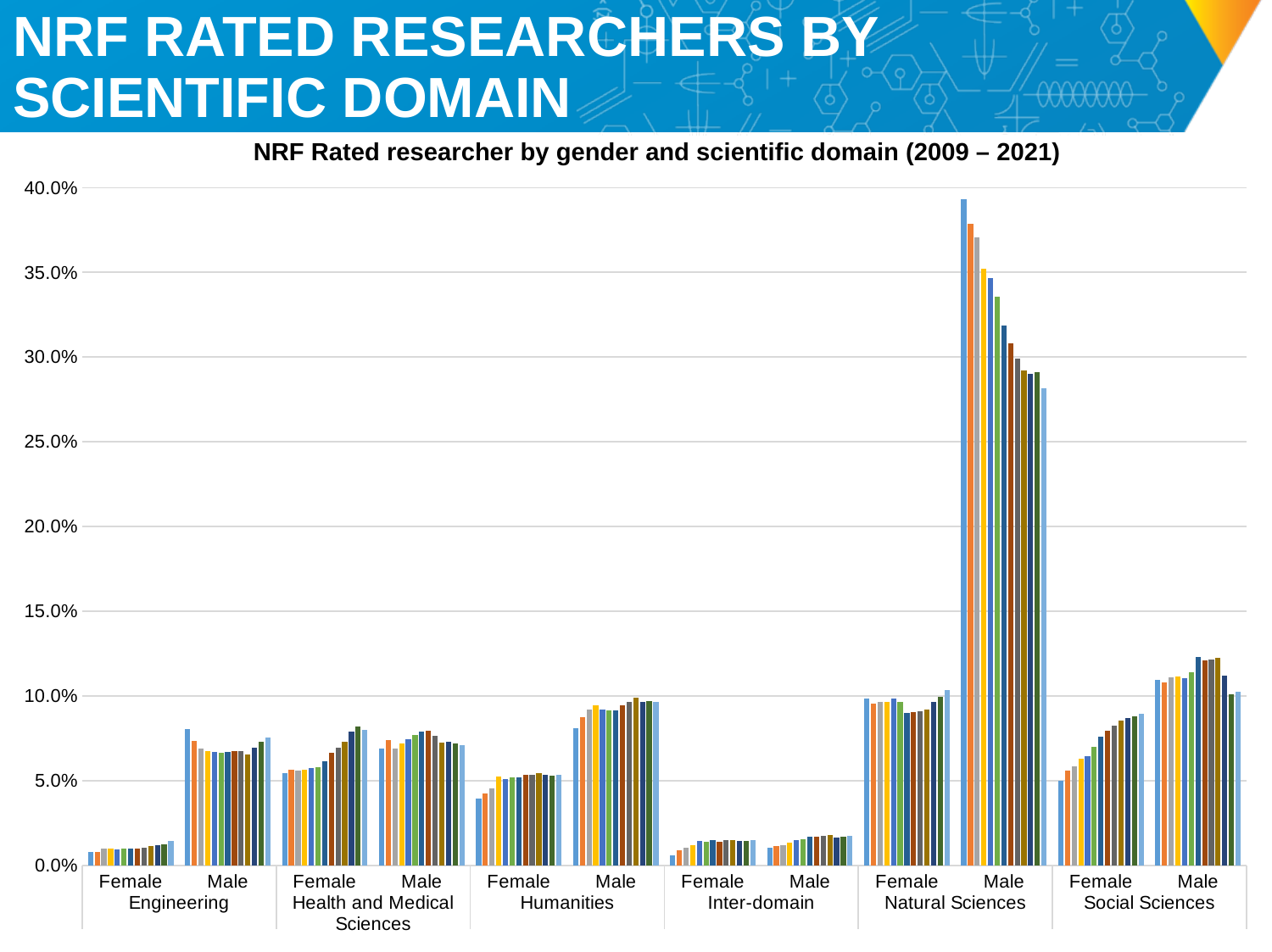
Are the values for Female Natural Sciences greater or less than 15.0%? less What kind of chart is shown on the slide? bar chart How many gender-by-domain groups of bars are shown on the x axis? 12 How many scientific domains are shown along the x axis? 6 Which group has larger values, Male Natural Sciences or Male Engineering? Male Natural Sciences Are the values for Female Engineering greater or less than 5.0%? less Which group of bars reaches the highest values in the chart? Male Natural Sciences Do the bars for Male Natural Sciences rise or fall from left to right across the years? fall What is the title of the chart? NRF Rated researcher by gender and scientific domain (2009 – 2021) Do the bars for Female Social Sciences rise or fall from left to right across the years? rise Are the values for Male Natural Sciences greater or less than 25.0%? greater